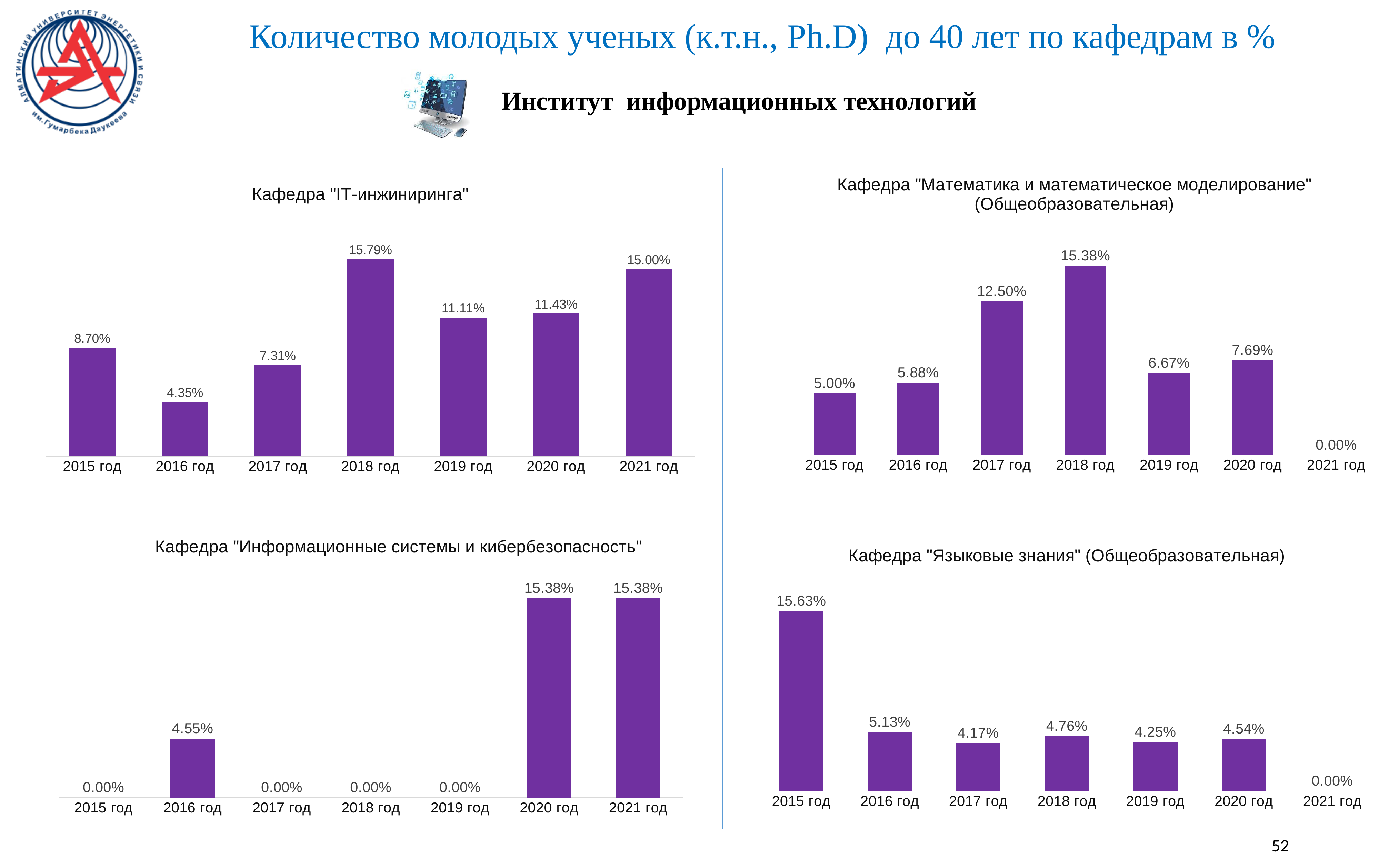
In the chart "Кафедра "IT-инжиниринга"", what is the difference between the values for 2021 год and 2020 год? 3.57% In the chart "Кафедра "IT-инжиниринга"", what is the value for 2018 год? 15.79% How many bar charts are shown on the slide? 4 In the chart "Кафедра "Языковые знания" (Общеобразовательная)", what is the value for 2015 год? 15.63% In the chart "Кафедра "Информационные системы и кибербезопасность"", how many years have a value of 0.00%? 4 In the chart "Кафедра "Математика и математическое моделирование" (Общеобразовательная)", which is larger, the value for 2019 год or 2020 год? 2020 год In the chart "Кафедра "IT-инжиниринга"", which year has the lowest value? 2016 год What type of chart is "Кафедра "IT-инжиниринга""? bar chart In the chart "Кафедра "Информационные системы и кибербезопасность"", what is the value for 2016 год? 4.55% In the chart "Кафедра "Математика и математическое моделирование" (Общеобразовательная)", which year has the highest value? 2018 год In the chart "Кафедра "Языковые знания" (Общеобразовательная)", what is the difference between the values for 2016 год and 2017 год? 0.96% In the chart "Кафедра "Математика и математическое моделирование" (Общеобразовательная)", what is the value for 2017 год? 12.50%